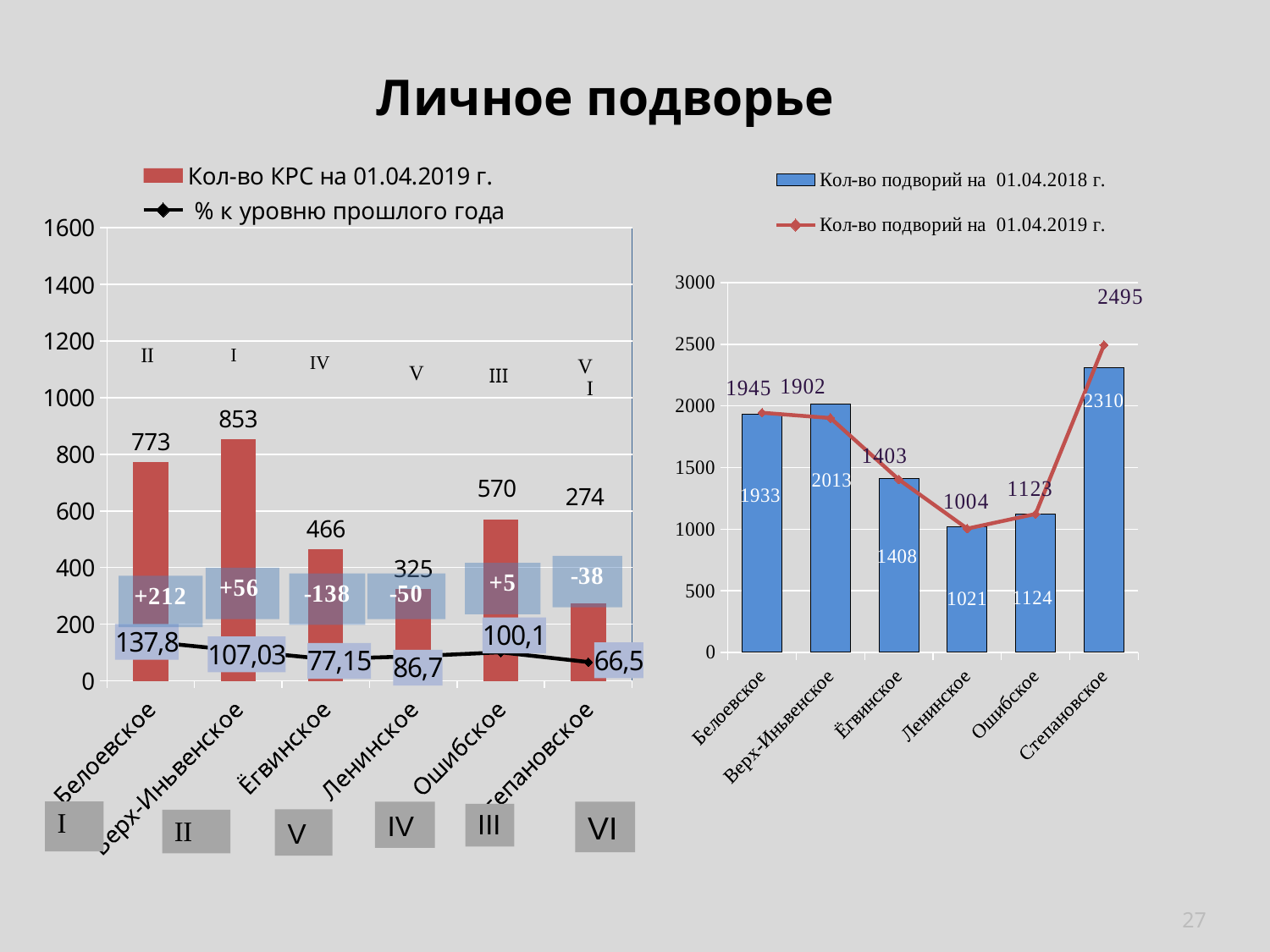
How many series does the legend of the right chart list? 2 On the left chart, what is the difference between the 'Кол-во КРС на 01.04.2019 г.' values for Белоевское and Ёгвинское? 307 On the right chart, what is the difference between 'Кол-во подворий на 01.04.2019 г.' and 'Кол-во подворий на 01.04.2018 г.' for Верх-Иньвенское? 111 On the left chart, which category has the lowest 'Кол-во КРС на 01.04.2019 г.' bar? Степановское On the right chart, what is the value of 'Кол-во подворий на 01.04.2018 г.' for Ленинское? 1021 On the left chart, which is larger: the 'Кол-во КРС на 01.04.2019 г.' value for Ошибское or for Ленинское? Ошибское On the left chart, what is the '% к уровню прошлого года' value for Ленинское? 86,7 On the right chart, which category has the highest 'Кол-во подворий на 01.04.2018 г.' bar? Степановское On the left chart, what is the value of 'Кол-во КРС на 01.04.2019 г.' for Верх-Иньвенское? 853 How many categories are shown on the x axis of the left chart? 6 On the right chart, what is the value of 'Кол-во подворий на 01.04.2019 г.' for Степановское? 2495 What is the title of the slide? Личное подворье